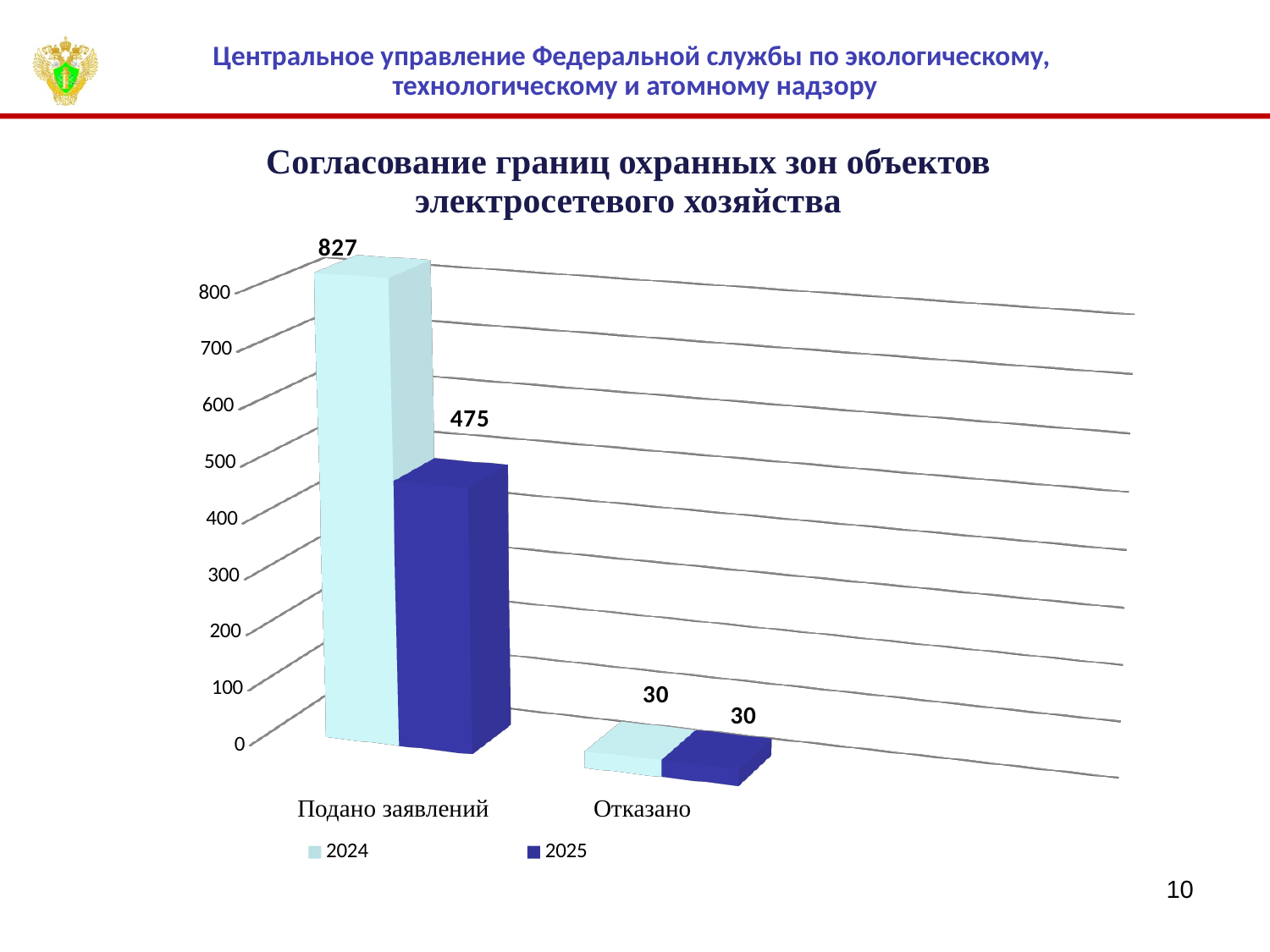
What is the difference between the 2024 and 2025 values for 'Подано заявлений'? 352 What is the value for 2025 in the 'Подано заявлений' category? 475 What is the difference between the 'Подано заявлений' and 'Отказано' values for 2025? 445 How many series does the legend list? 2 What kind of chart is shown on the slide? Bar chart How many categories are shown on the x axis? 2 What is the value for 2024 in the 'Отказано' category? 30 Which series has the higher value for 'Подано заявлений', 2024 or 2025? 2024 Which category has the lowest value for 2024? Отказано What is the value for 2025 in the 'Отказано' category? 30 What is the value for 2024 in the 'Подано заявлений' category? 827 What is the title of the chart? Согласование границ охранных зон объектов электросетевого хозяйства